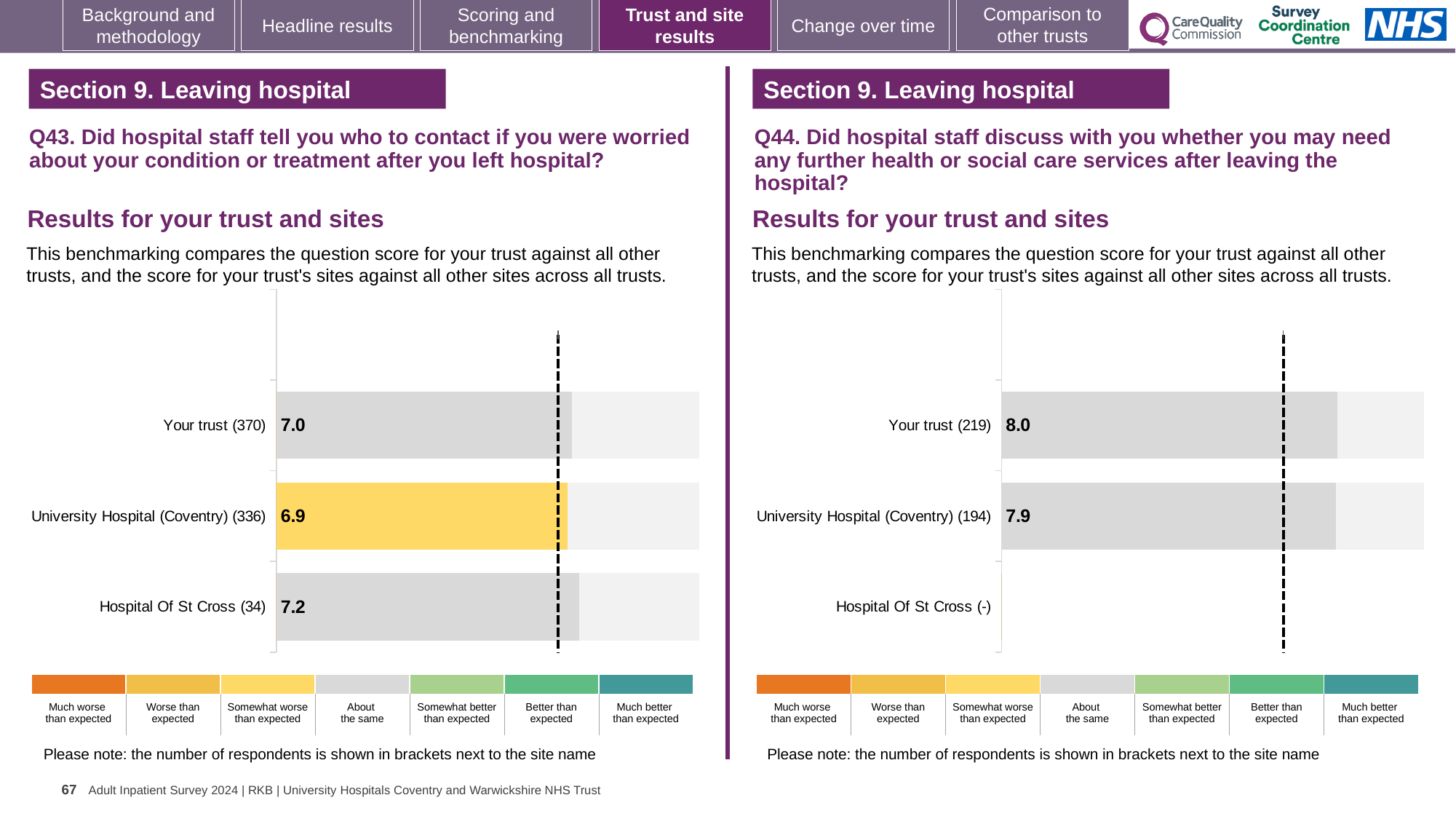
In the Q44 chart on the right, which has the larger score, Your trust or University Hospital (Coventry)? Your trust In the Q43 chart on the left, which site or trust has the lowest score? University Hospital (Coventry) What kind of chart is used in the Q43 chart on the left? Bar chart In the Q43 chart on the left, which site or trust has the highest score? Hospital Of St Cross In the Q43 chart on the left, what is the difference between the scores for Hospital Of St Cross and University Hospital (Coventry)? 0.3 In the Q43 chart on the left, how many respondents are shown for Your trust? 370 In the Q43 chart on the left, what is the score for Hospital Of St Cross? 7.2 In the Q44 chart on the right, what is the score for University Hospital (Coventry)? 7.9 In the Q44 chart on the right, how many respondents are shown for University Hospital (Coventry)? 194 In the Q43 chart on the left, what is the score for University Hospital (Coventry)? 6.9 In the Q43 chart on the left, what is the score for Your trust? 7.0 In the Q44 chart on the right, what is the score for Your trust? 8.0